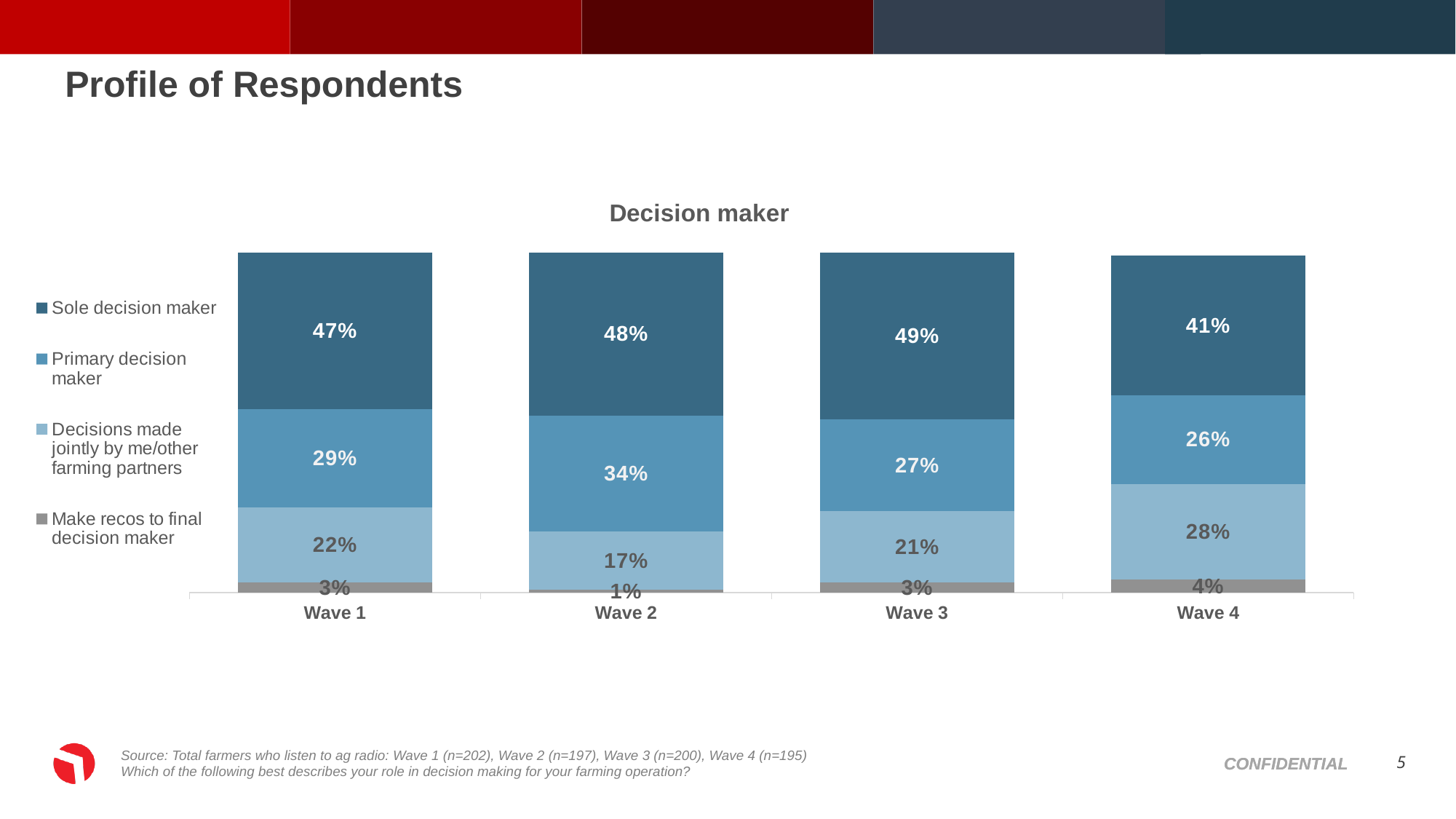
What is the title of the chart? Decision maker In which wave is the Primary decision maker share highest? Wave 2 How many waves (categories) are shown on the x axis? 4 What is the value for Sole decision maker in Wave 3? 49% What is the difference between the Sole decision maker values in Wave 3 and Wave 4? 8% Which is larger in Wave 4: Primary decision maker or Decisions made jointly by me/other farming partners? Decisions made jointly by me/other farming partners What kind of chart is shown on the slide? Stacked bar chart In which wave is the Sole decision maker share lowest? Wave 4 How many series does the legend list? 4 What is the value for Primary decision maker in Wave 2? 34% What is the value for Decisions made jointly by me/other farming partners in Wave 4? 28% What is the value for Make recos to final decision maker in Wave 2? 1%